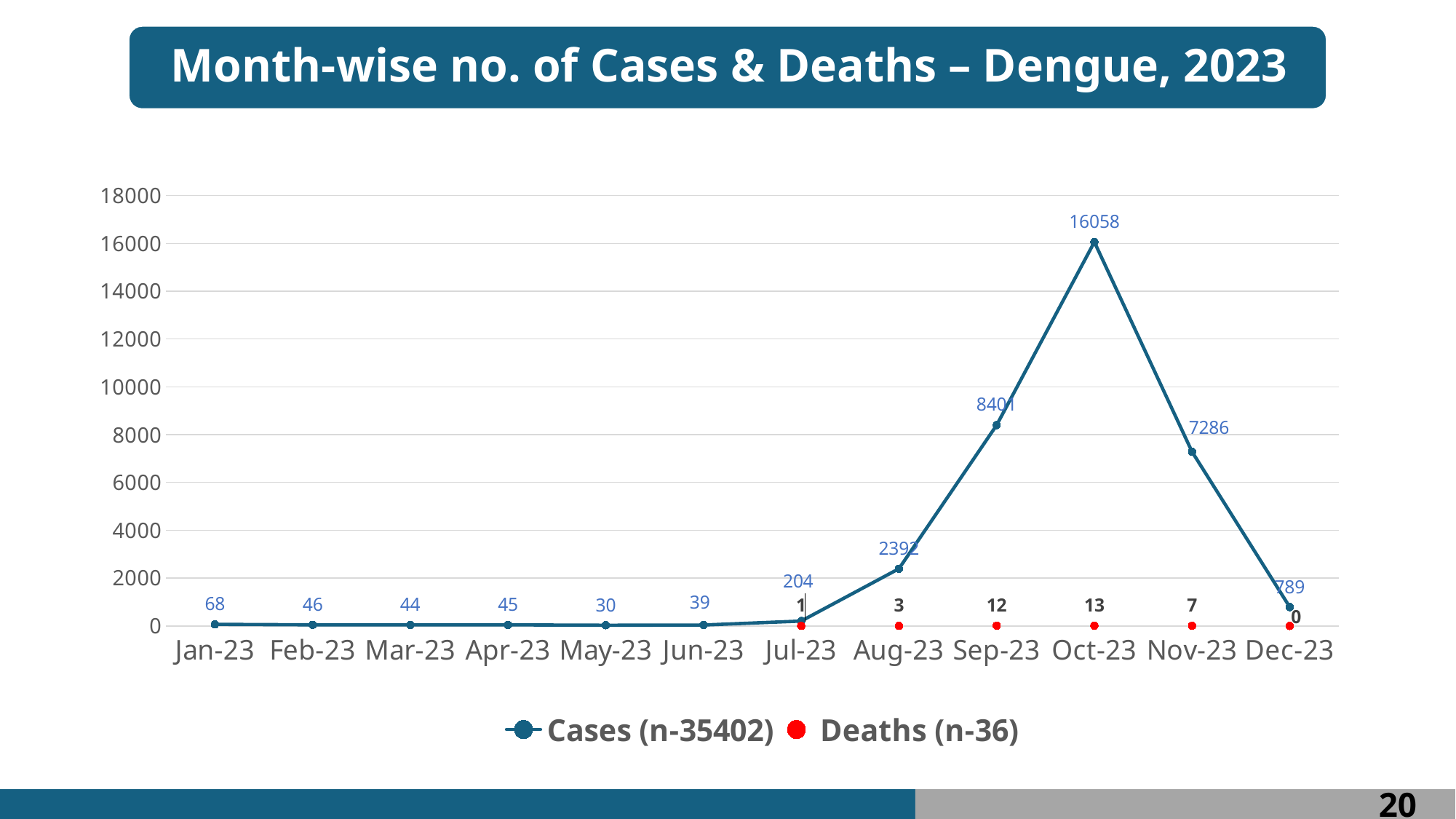
How many months are shown on the x axis? 12 Which month had more cases, Aug-23 or Dec-23? Aug-23 What kind of chart is this? Line chart Do the cases rise or fall from Oct-23 to Dec-23? Fall How many series does the legend list? 2 Which month had the highest number of cases? Oct-23 How many dengue cases were reported in Oct-23? 16058 Which month had the lowest number of cases? May-23 What is the difference in cases between Oct-23 and Nov-23? 8772 How many deaths were reported in Sep-23? 12 How many cases were reported in Jul-23? 204 According to the legend, what is the total number of deaths (n)? 36